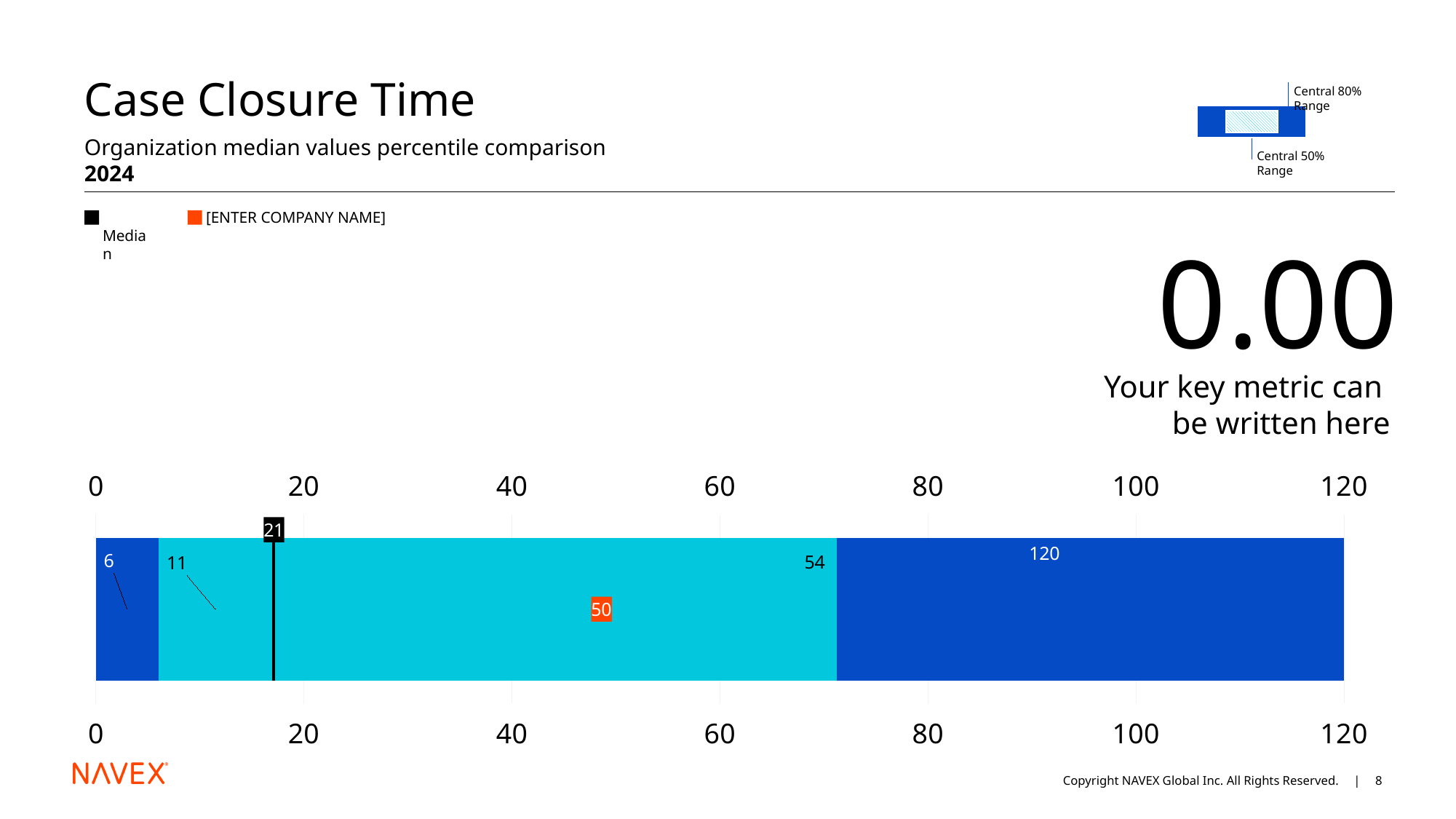
What is the title of the chart on the slide? Case Closure Time What is the median value marked on the bar? 21 Which is larger, the median value or the [ENTER COMPANY NAME] value? [ENTER COMPANY NAME] value What type of chart is shown on the slide? bar chart How many values are labeled on the bar? 6 What is the maximum value shown on the x axis? 120 What is the highest value labeled on the bar? 120 What is the difference between the [ENTER COMPANY NAME] value and the median value? 29 What is the difference between the values labeled 54 and 11 on the bar? 43 What is the lowest value labeled on the bar? 6 What value is marked for [ENTER COMPANY NAME] on the bar? 50